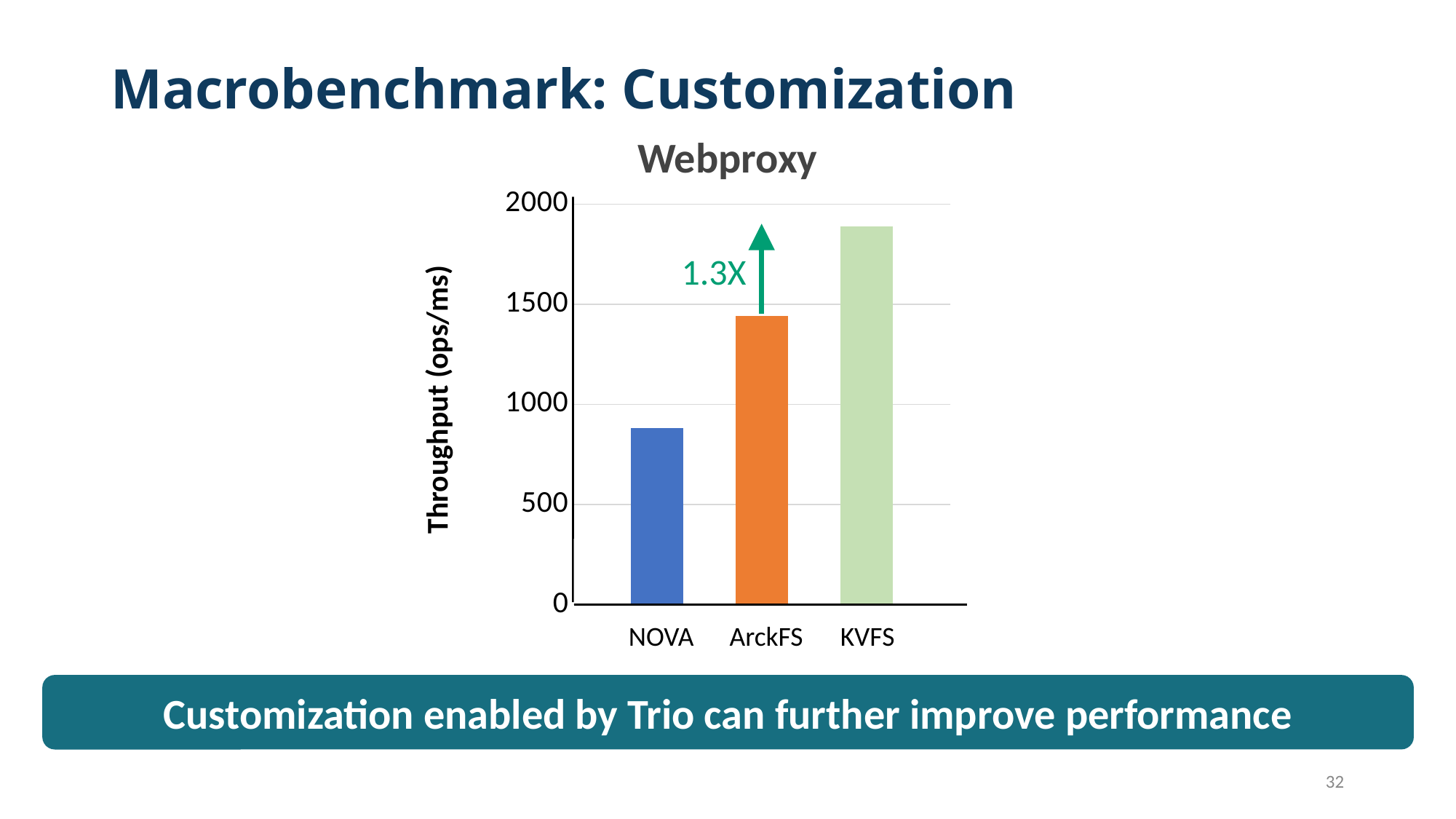
Which category has the highest throughput? KVFS What is the label on the y axis of the chart? Throughput (ops/ms) Which has a higher throughput, NOVA or ArckFS? ArckFS Is the value for NOVA greater or less than 1000? less Is the value for KVFS greater or less than 1500? greater Which has a higher throughput, ArckFS or KVFS? KVFS How many categories are plotted on the x axis? 3 What kind of chart is shown on the slide? bar chart Which category has the lowest throughput? NOVA Is the value for NOVA greater or less than 500? greater What is the title of the chart? Webproxy Do the throughput values rise or fall from NOVA to KVFS along the x axis? rise